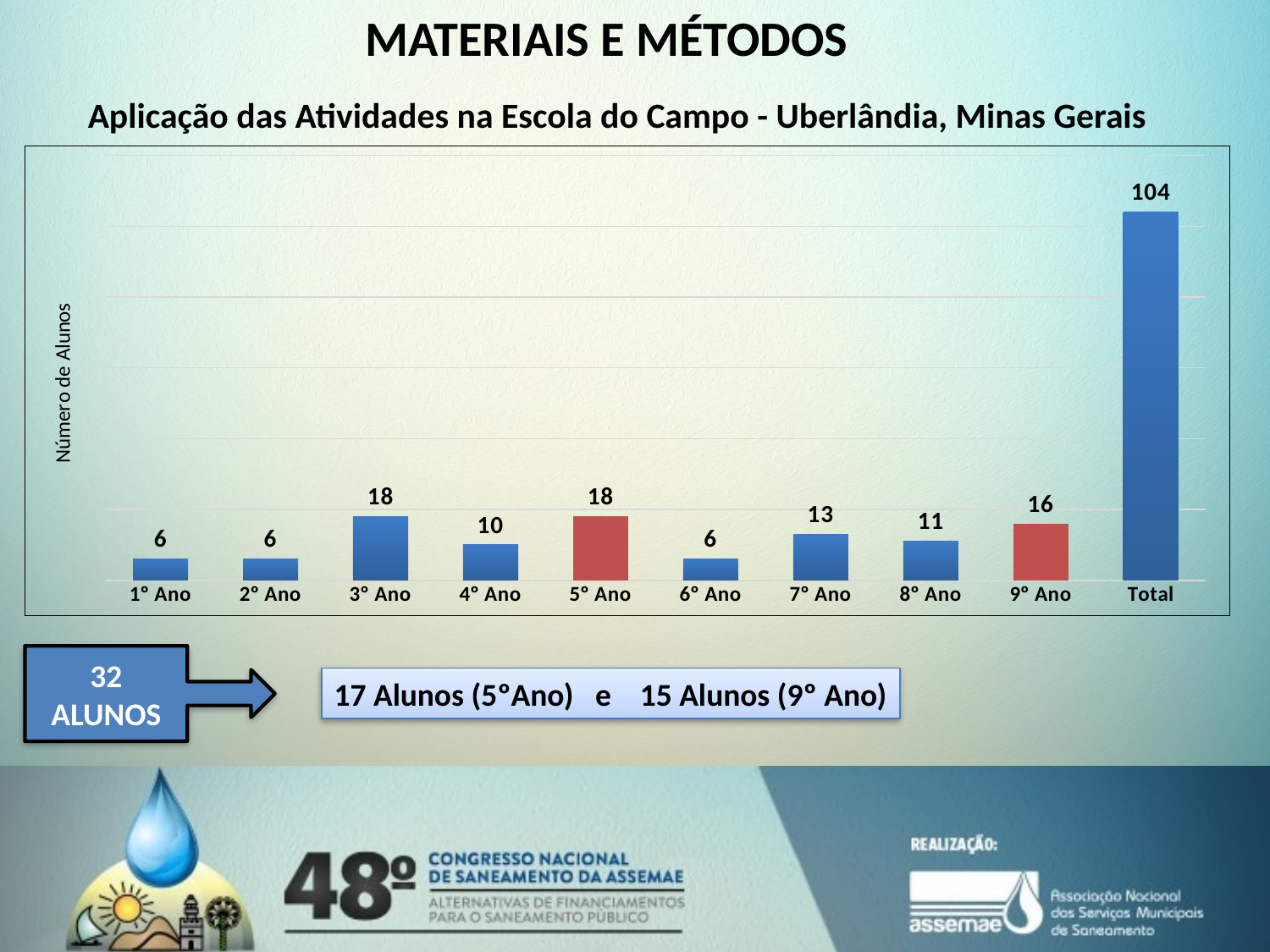
Which category has the highest value? Total What is the value for 7° Ano? 13 What is the value for 9° Ano? 16 Which is larger, the value for 7° Ano or the value for 8° Ano? 7° Ano Which two categories are drawn with red bars? 5° Ano and 9° Ano What is the value for the Total bar? 104 What is the value for 3° Ano? 18 How many categories are shown on the x axis? 10 What kind of chart is shown on the slide? Bar chart What is the difference between the values for 5° Ano and 4° Ano? 8 What is the difference between the values for 9° Ano and 8° Ano? 5 What is the value for 4° Ano? 10